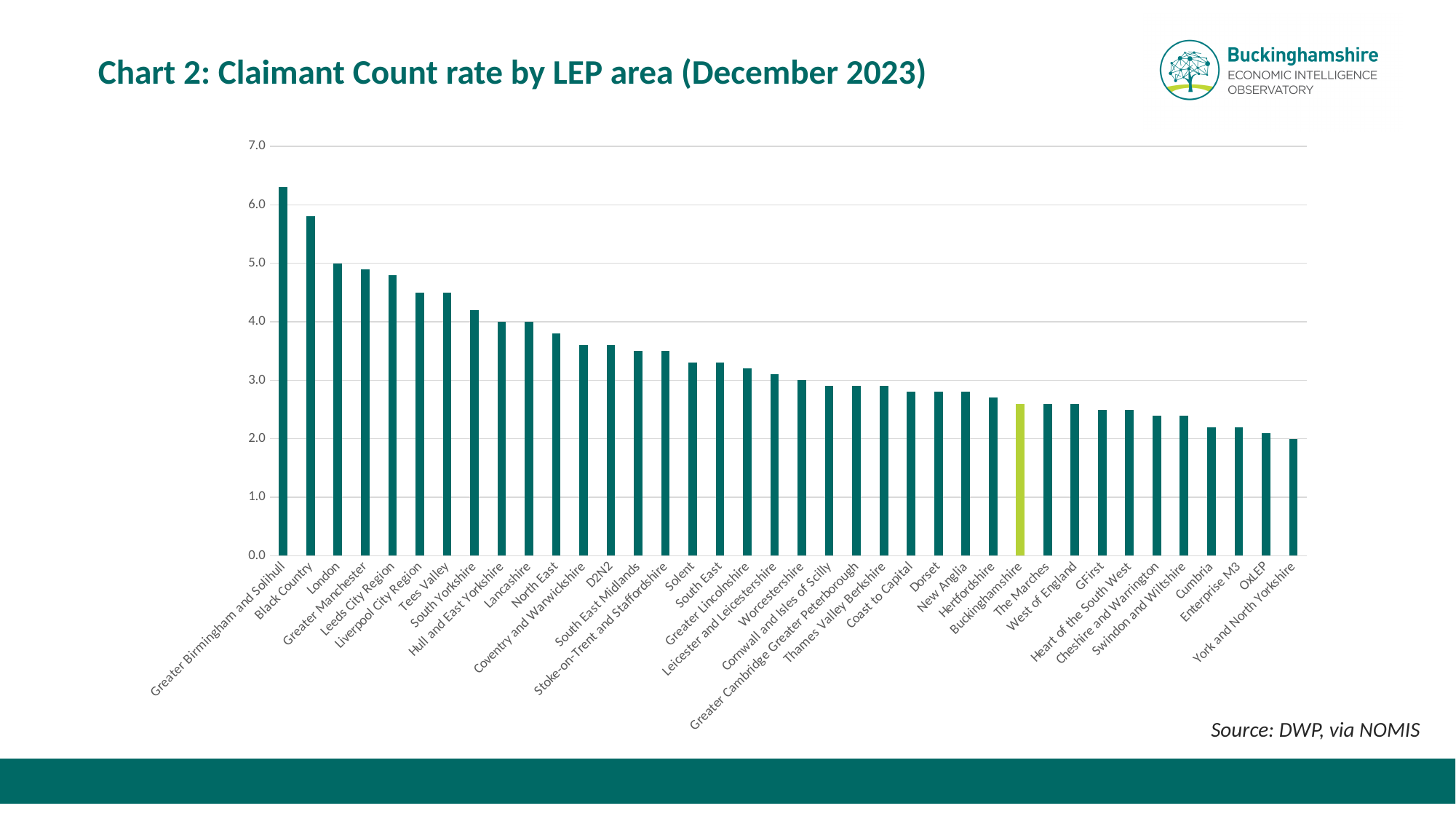
Do the claimant count rates rise or fall moving from left to right along the x axis? Fall Is the claimant count rate for Black Country greater or less than 5.0? greater What kind of chart is shown on the slide? Bar chart Which has the higher claimant count rate, Black Country or London? Black Country Is the claimant count rate for Buckinghamshire greater or less than 3.0? less Is the claimant count rate for Tees Valley greater or less than 5.0? less Which LEP area has the highest claimant count rate? Greater Birmingham and Solihull Which has the higher claimant count rate, Dorset or Cumbria? Dorset Which LEP area's bar is highlighted in a different (light green) colour from the rest? Buckinghamshire Which LEP area has the lowest claimant count rate? York and North Yorkshire How many LEP areas are plotted on the chart? 38